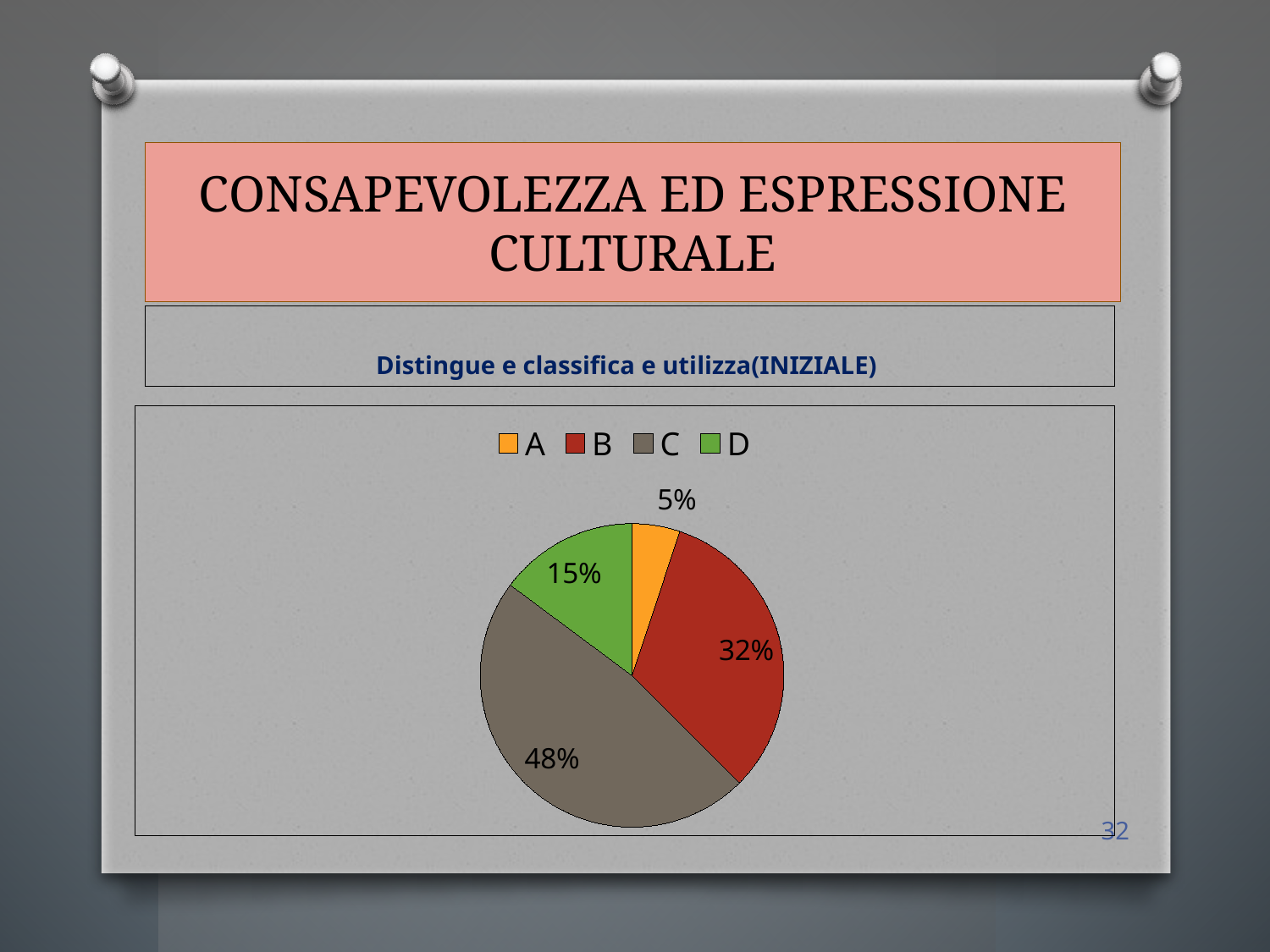
Which category has the largest slice of the pie? C How many slices does the pie chart have? 4 What percentage does slice B represent? 32% What kind of chart is shown on the slide? pie chart What percentage does slice D represent? 15% What is the difference in percentage points between slice C and slice B? 16 Which is larger, slice B or slice D? B Which category has the smallest slice of the pie? A How many entries does the legend list? 4 What percentage does slice C represent? 48% What percentage does slice A represent? 5% What colour is the slice for category D? green